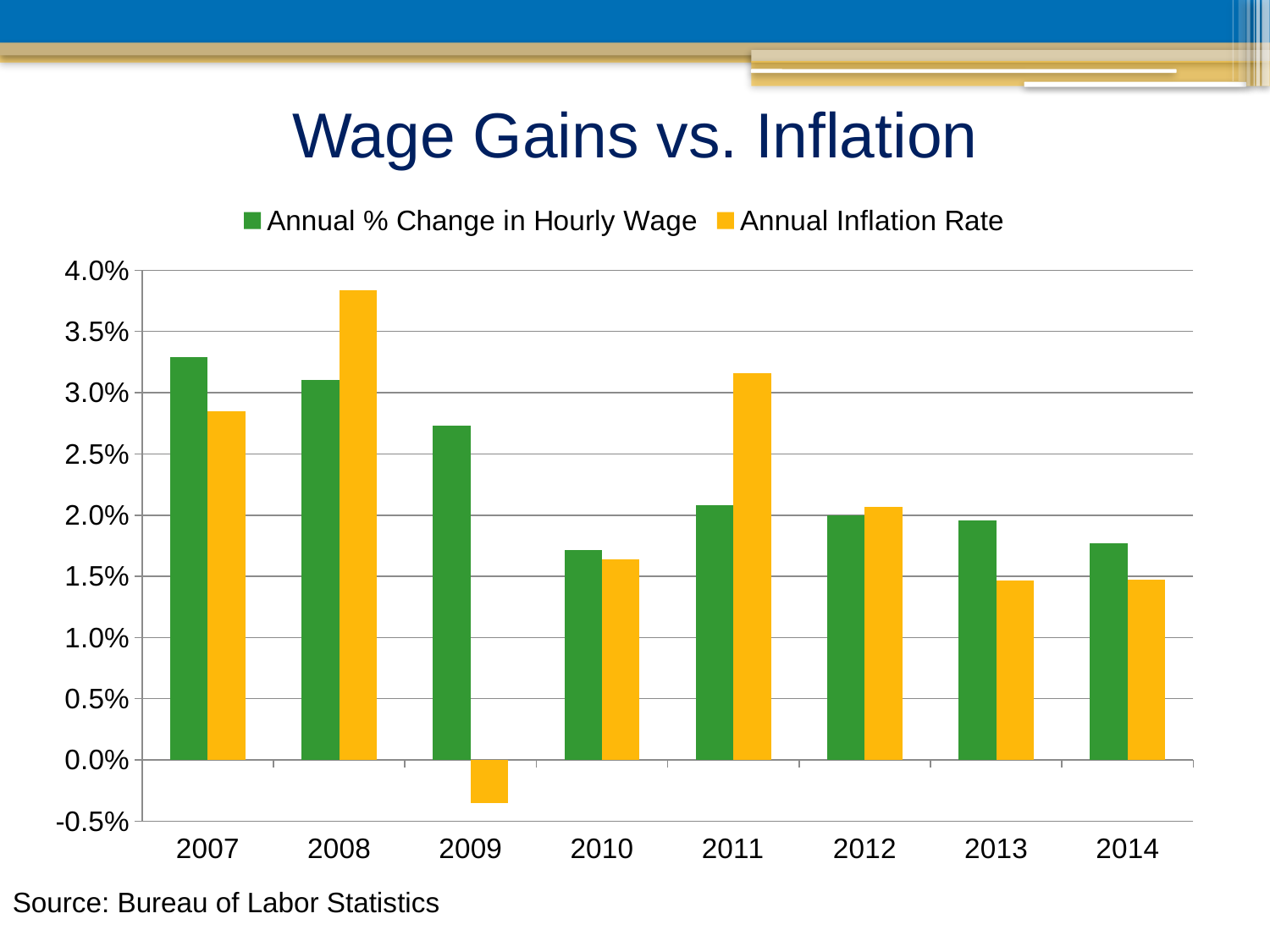
What is the title of the chart? Wage Gains vs. Inflation What kind of chart is shown on the slide? bar chart How many years are shown on the x axis? 8 Is the Annual % Change in Hourly Wage for 2007 greater or less than 3.0%? greater In 2008, which is larger: the Annual % Change in Hourly Wage or the Annual Inflation Rate? Annual Inflation Rate In which year is the Annual Inflation Rate highest? 2008 In which year is the Annual Inflation Rate lowest? 2009 In which year is the Annual % Change in Hourly Wage highest? 2007 How many series does the legend list? 2 In 2009, which is larger: the Annual % Change in Hourly Wage or the Annual Inflation Rate? Annual % Change in Hourly Wage Does the Annual % Change in Hourly Wage generally rise or fall from 2007 to 2014? fall Is the Annual Inflation Rate for 2009 greater or less than 0.0%? less